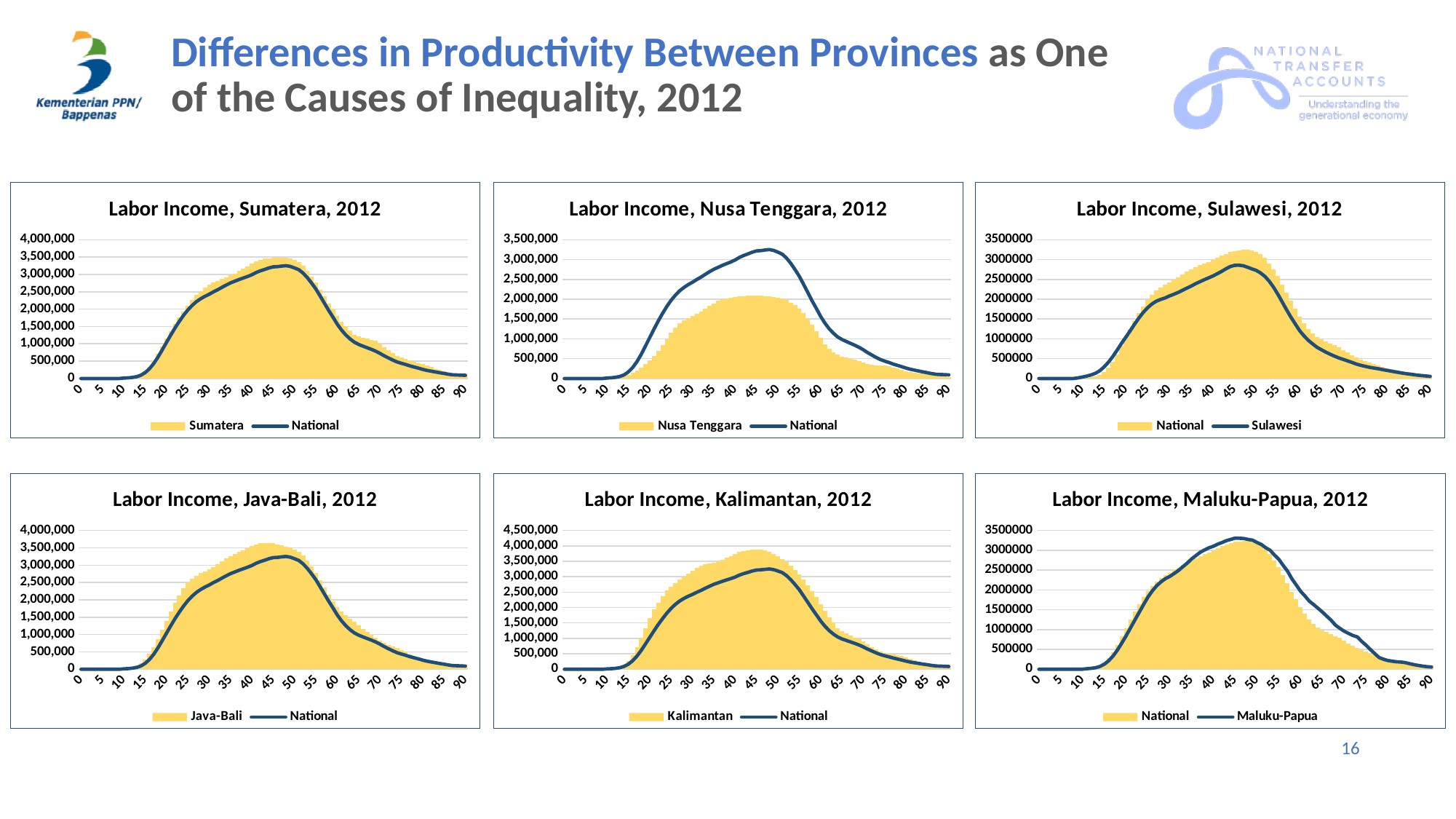
How many series does the legend list in the 'Labor Income, Sumatera, 2012' chart? 2 In the 'Labor Income, Kalimantan, 2012' chart, which is higher at age 45, Kalimantan or National? Kalimantan In the 'Labor Income, Nusa Tenggara, 2012' chart, which is higher at age 40, Nusa Tenggara or National? National In the 'Labor Income, Nusa Tenggara, 2012' chart, is the Nusa Tenggara value at age 45 greater or less than 2,500,000? less In the 'Labor Income, Sumatera, 2012' chart, does the National line rise or fall from age 50 to age 90? fall What are the legend entries in the 'Labor Income, Nusa Tenggara, 2012' chart? Nusa Tenggara and National In the 'Labor Income, Kalimantan, 2012' chart, is the Kalimantan value at age 45 greater or less than 3,500,000? greater How many charts are shown on the slide? 6 In the 'Labor Income, Nusa Tenggara, 2012' chart, is the National value at age 45 greater or less than 3,000,000? greater In the 'Labor Income, Maluku-Papua, 2012' chart, which is higher at age 65, Maluku-Papua or National? Maluku-Papua In the 'Labor Income, Sulawesi, 2012' chart, which series is drawn as a line rather than a shaded area? Sulawesi